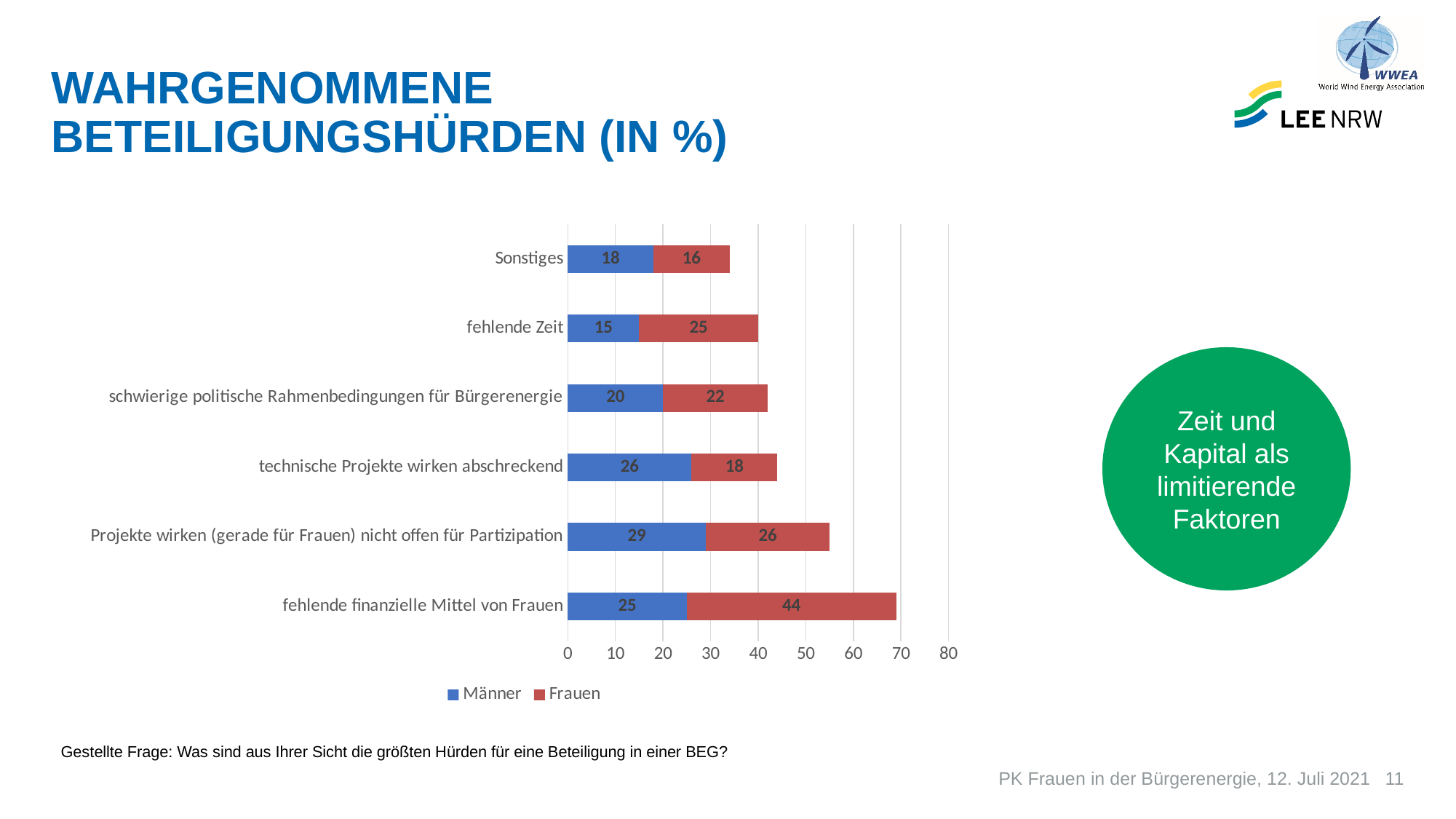
What is the Frauen value for "fehlende finanzielle Mittel von Frauen"? 44 What is the total of the stacked bar for "Projekte wirken (gerade für Frauen) nicht offen für Partizipation"? 55 What is the Frauen value for "Sonstiges"? 16 What is the Männer value for "fehlende Zeit"? 15 Which colour represents the Frauen series? Red What kind of chart is shown on the slide? Stacked bar chart Which is larger for "technische Projekte wirken abschreckend": the Männer value or the Frauen value? Männer How many series does the legend list? 2 How many categories are shown on the chart? 6 Which category has the highest Frauen value? fehlende finanzielle Mittel von Frauen What is the difference between the Frauen and Männer values for "fehlende finanzielle Mittel von Frauen"? 19 Which category has the lowest Männer value? fehlende Zeit